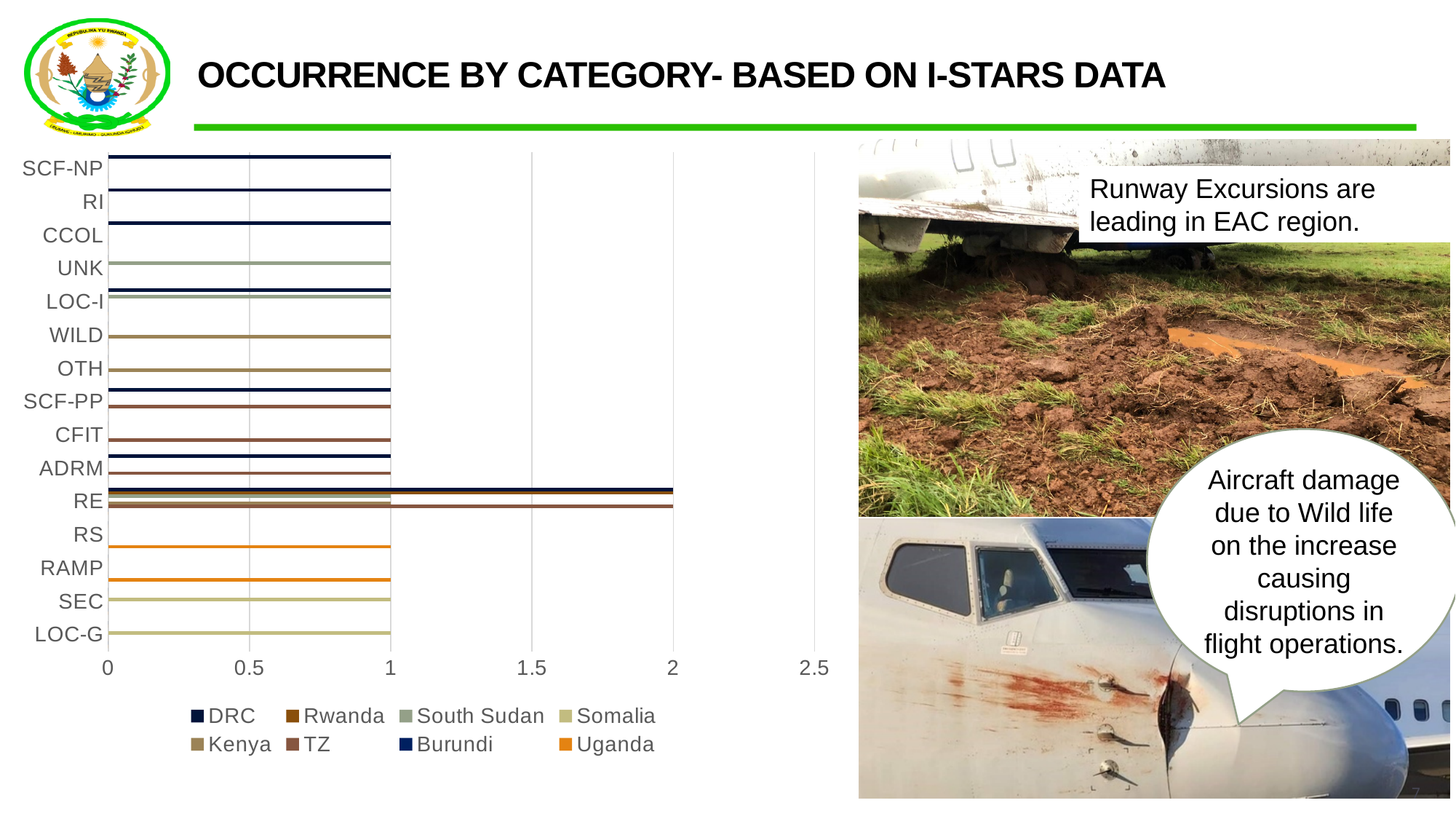
Is the value for CFIT greater or less than 1.5? less How many categories are listed on the vertical axis of the chart? 15 Is the longest bar for RE greater or less than 1.5? greater What is the difference between the longest bar for RE and the bar for OTH? 1 Which category has the longest bar in the chart? RE What value does the longest bar for RE reach? 2 What is the highest value shown on the horizontal axis? 2.5 What value does the bar for LOC-G reach? 1 What value does the bar for WILD reach? 1 What is the title of the slide's chart? OCCURRENCE BY CATEGORY- BASED ON I-STARS DATA What type of chart is shown on the slide? bar chart How many series does the chart legend list? 8